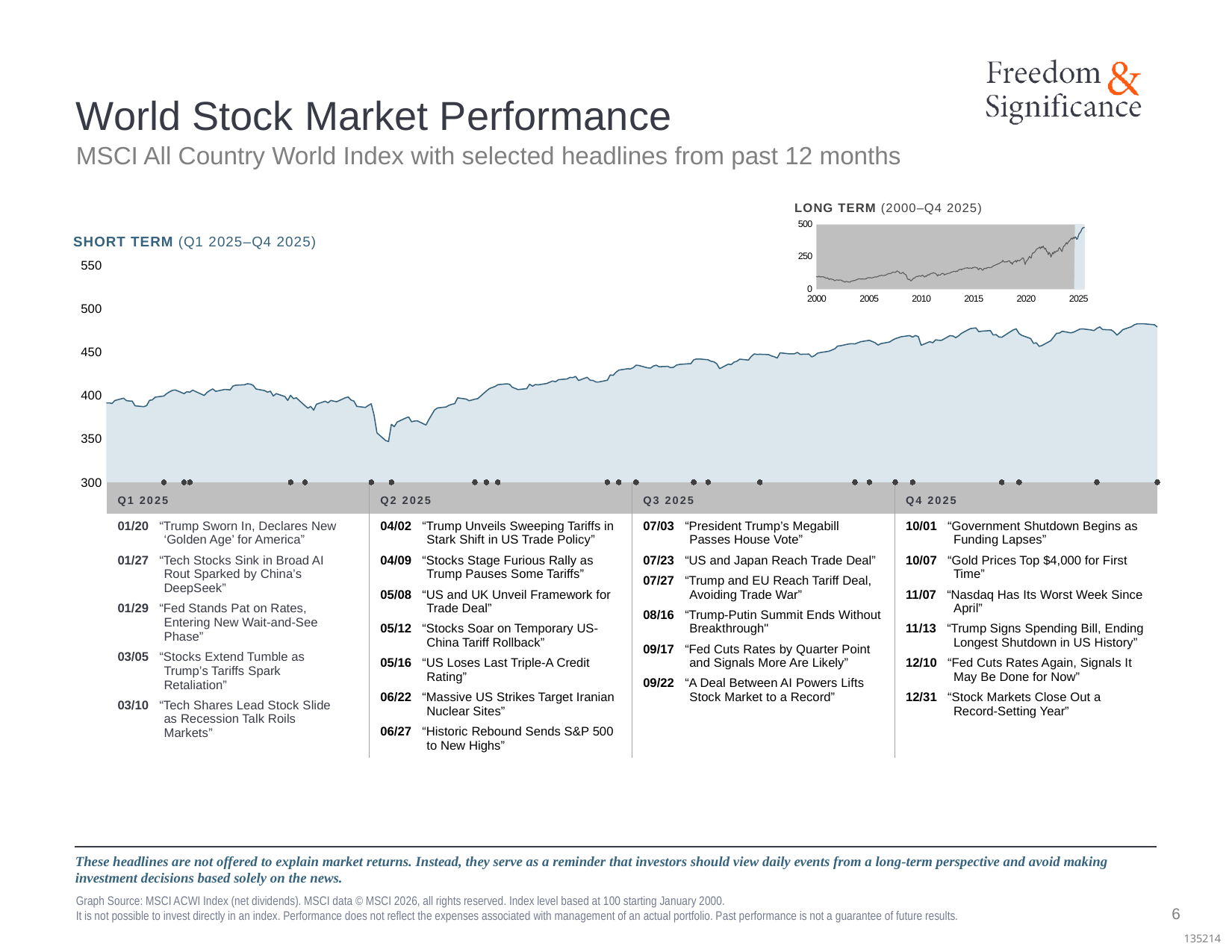
In the SHORT TERM chart, is the lowest point of the line greater or less than 400? less What is the highest value shown on the y axis of the SHORT TERM chart? 550 In the SHORT TERM chart, is the index level at the end of Q4 2025 higher or lower than at the start of Q1 2025? higher What kind of chart is the SHORT TERM chart on the slide? line chart In the LONG TERM chart, is the index level at 2000 greater or less than 250? less In the SHORT TERM chart, is the index level at the start of Q1 2025 greater or less than 450? less In the LONG TERM chart, does the index level overall rise or fall from 2000 to 2025? rise What period does the LONG TERM chart cover, according to its title? 2000–Q4 2025 In the SHORT TERM chart, does the index level overall rise or fall from Q1 2025 to Q4 2025? rise How many quarters are labelled along the x axis of the SHORT TERM chart? 4